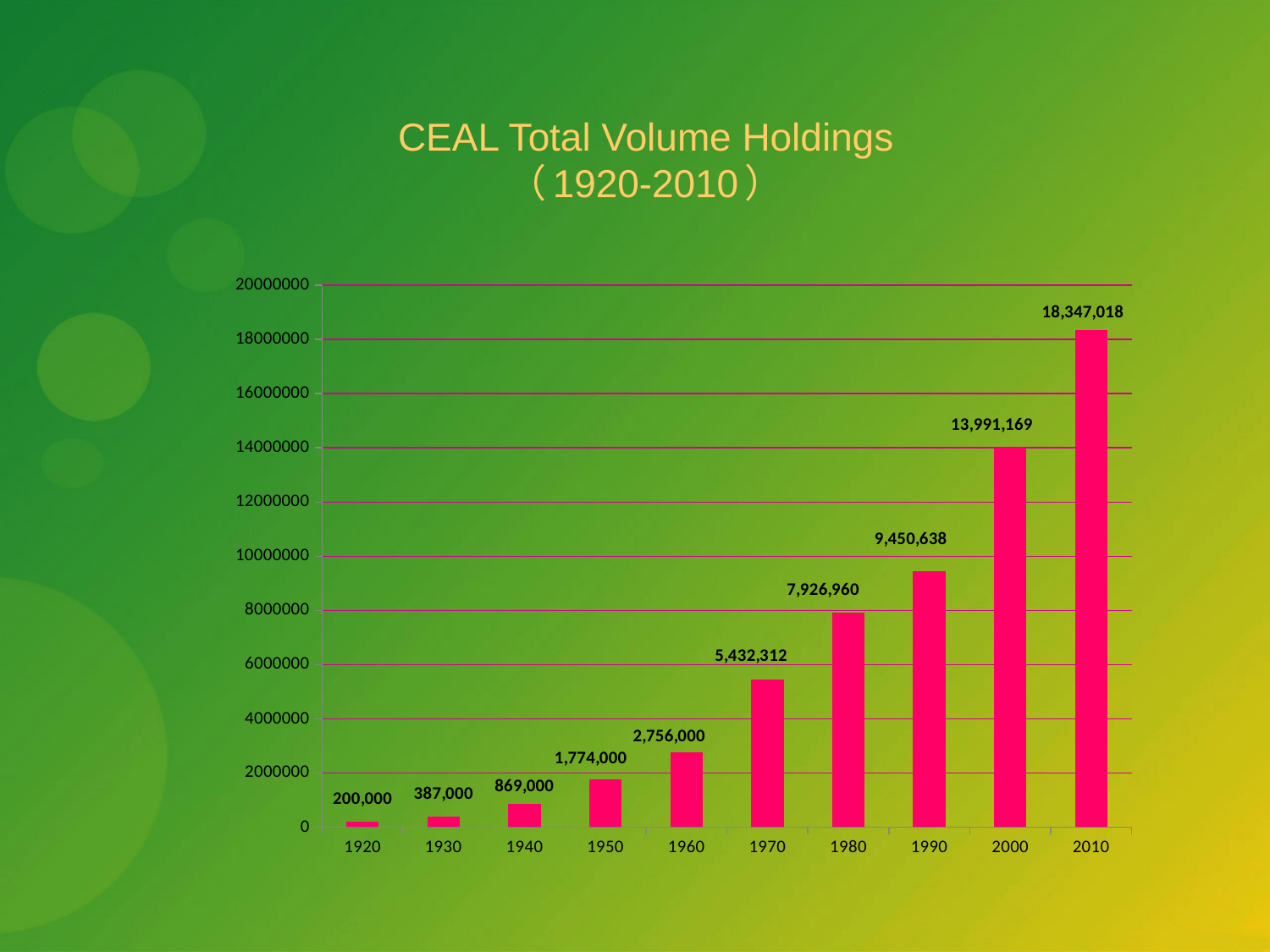
What is the difference between the values for 1990 and 1980? 1,523,678 Which year has the highest value? 2010 What is the value for 2000? 13,991,169 What kind of chart is this? bar chart What is the value for 1970? 5,432,312 Is the value for 1980 greater or less than 6000000? greater Which year has the lowest value? 1920 Which is larger, the value for 1960 or the value for 1950? 1960 Do the values rise or fall from 1920 to 2010? rise How many years are shown on the x axis? 10 What is the value for 1940? 869,000 What is the difference between the values for 2010 and 2000? 4,355,849